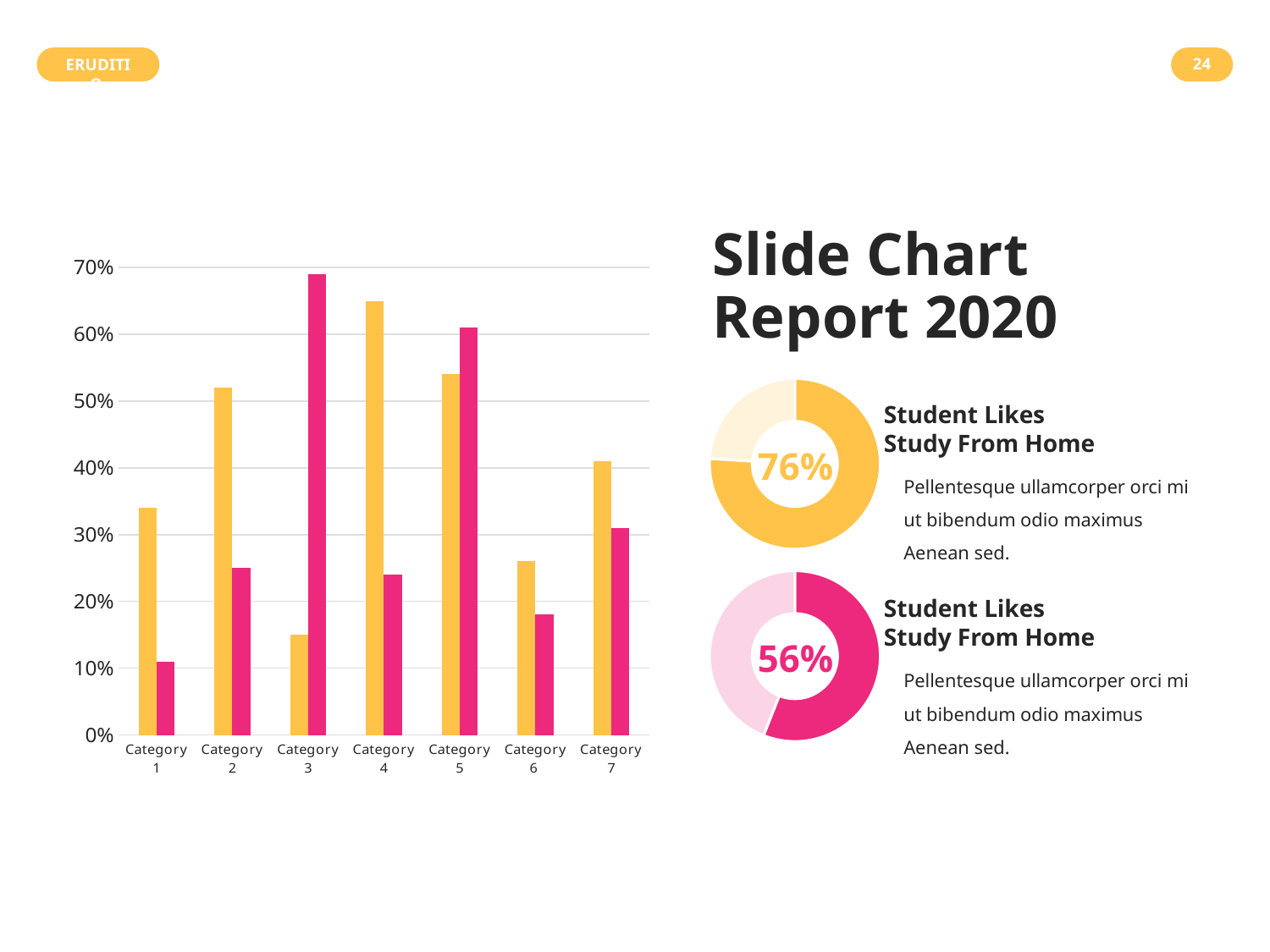
What is the difference between the percentage in the upper donut chart and the percentage in the lower donut chart? 20% In the bar chart on the left, which category has the tallest yellow bar? Category 4 In the bar chart on the left, is the yellow bar for Category 1 greater or less than 30%? greater In the bar chart on the left, is the pink bar for Category 7 greater or less than 40%? less In the bar chart on the left, for Category 7, is the yellow bar or the pink bar taller? yellow What percentage is shown in the upper (yellow) donut chart on the right? 76% In the bar chart on the left, which category has the shortest pink bar? Category 1 What kind of chart is the chart on the left side of the slide? bar chart In the bar chart on the left, which category has the shortest yellow bar? Category 3 In the bar chart on the left, for Category 5, is the yellow bar or the pink bar taller? pink In the bar chart on the left, which category has the tallest pink bar? Category 3 How many categories are shown on the x axis of the bar chart on the left? 7